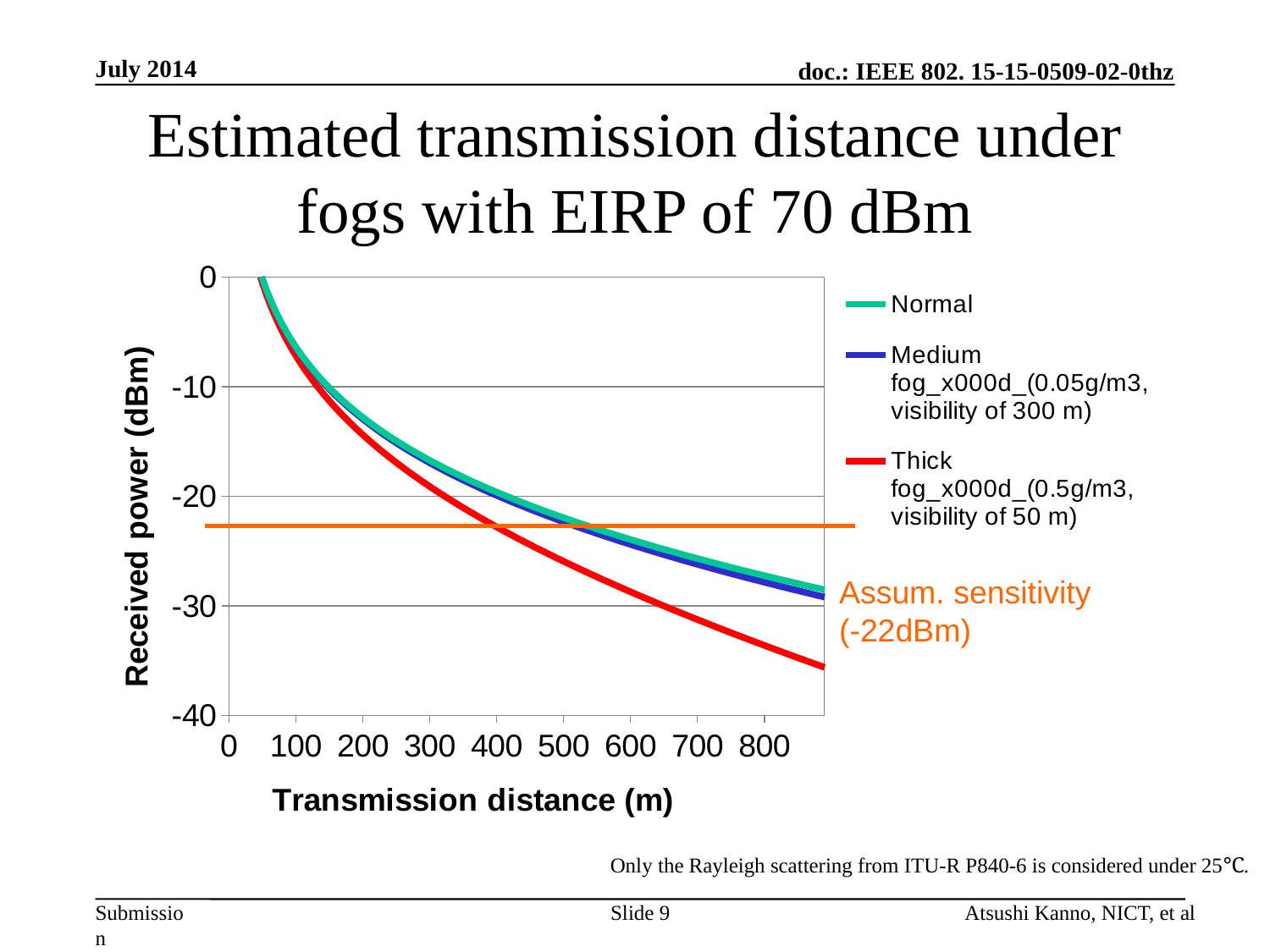
Does the received power rise or fall as transmission distance increases? Fall How many series does the legend list? 3 Is the received power for Thick fog at 600 m greater or less than -20 dBm? less What assumed sensitivity value is marked by the orange horizontal line? -22dBm Is the received power for Normal at 100 m greater or less than -10 dBm? greater What is the label of the y axis? Received power (dBm) Is the received power for Normal at 800 m greater or less than -30 dBm? greater Which series has the lowest received power at 800 m? Thick fog What kind of chart is shown on the slide? Line chart At 800 m, which series has the higher received power: Normal or Thick fog? Normal